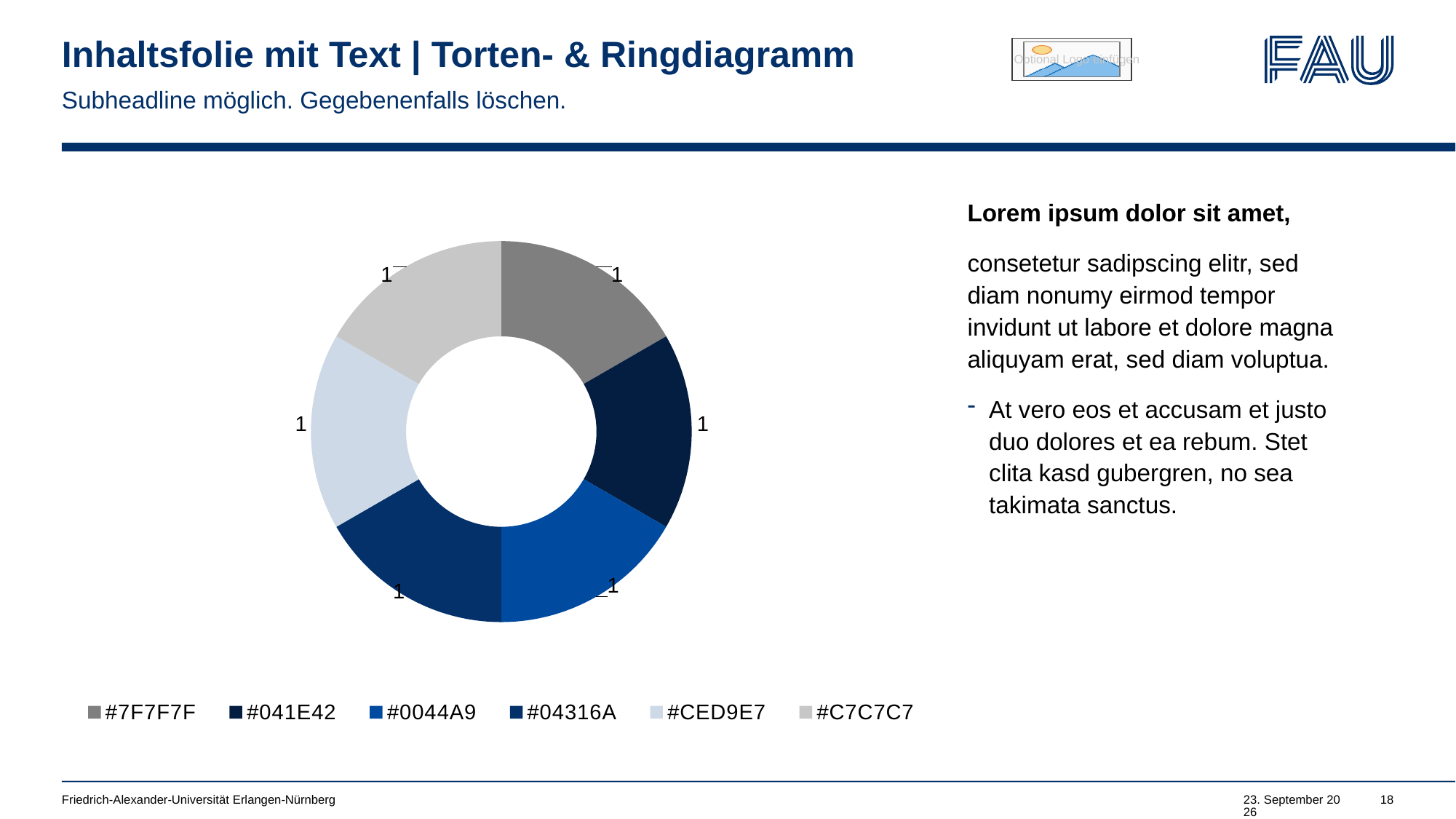
What kind of chart is shown on the slide? Doughnut chart What is the value of the #0044A9 slice in the doughnut chart? 1 What is the difference between the values of the #041E42 and #C7C7C7 slices? 0 Where is the legend positioned relative to the doughnut chart? Below the chart How many entries does the legend of the doughnut chart list? 6 What fraction of the doughnut chart does the #C7C7C7 slice represent? 1/6 Which legend entry is shown in the lightest blue colour? #CED9E7 What is the value of the #CED9E7 slice in the doughnut chart? 1 Is the value of the #04316A slice larger than, smaller than, or equal to the value of the #7F7F7F slice? Equal What is the value of the #7F7F7F slice in the doughnut chart? 1 What is the total of all slice values in the doughnut chart? 6 How many slices does the doughnut chart have? 6